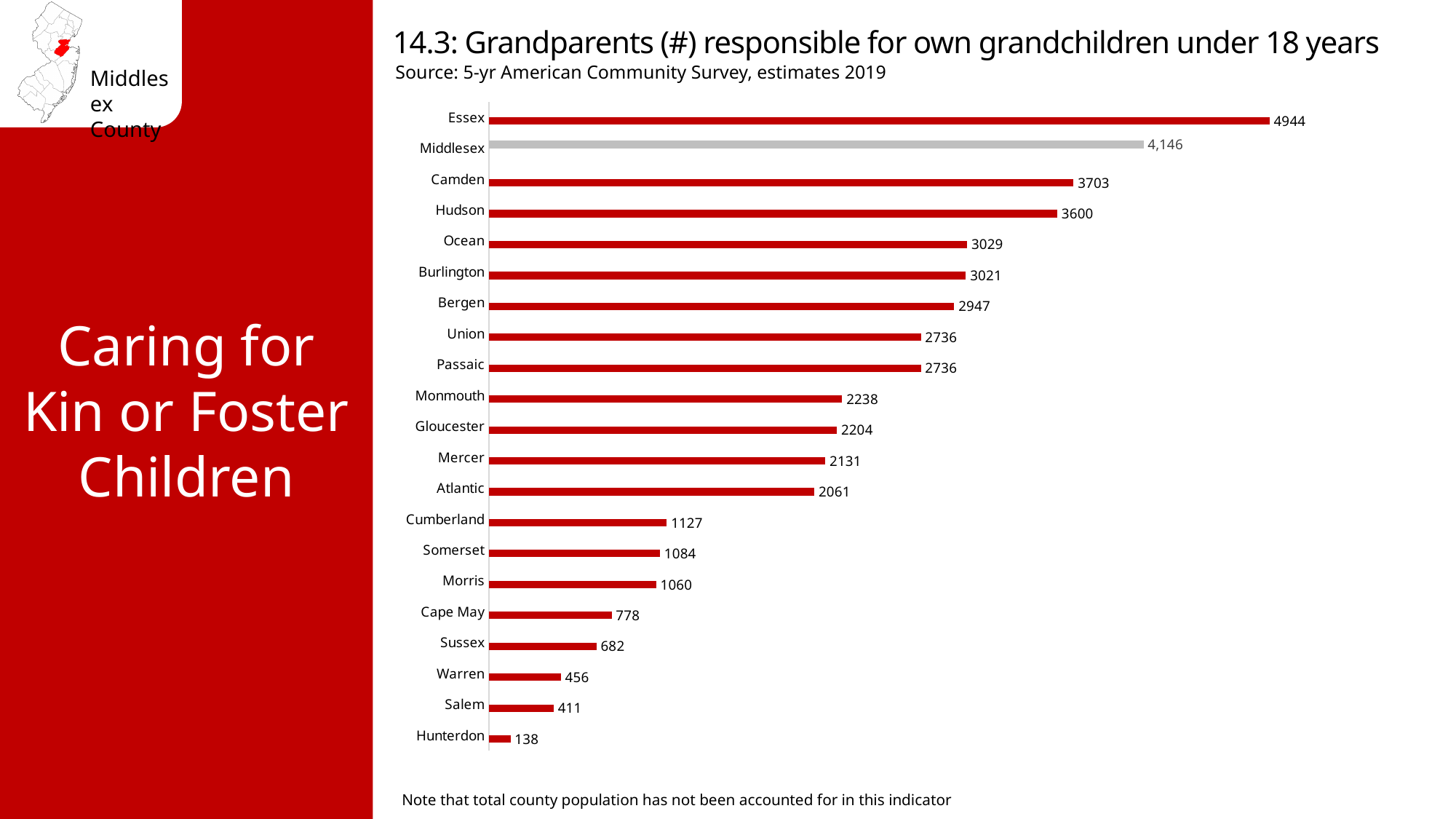
What is the difference between the values for Essex and Camden? 1241 What kind of chart is shown on the slide? Bar chart What is the value for Cape May? 778 Which two counties have the same value of 2736? Union and Passaic What is the value for Middlesex? 4,146 What is the difference between the values for Warren and Salem? 45 Which county has the highest value? Essex Which is larger, the value for Monmouth or the value for Atlantic? Monmouth What is the value for Hudson? 3600 Which county has the lowest value? Hunterdon How many counties are shown in the chart? 21 Which county's bar is shown in grey rather than red? Middlesex